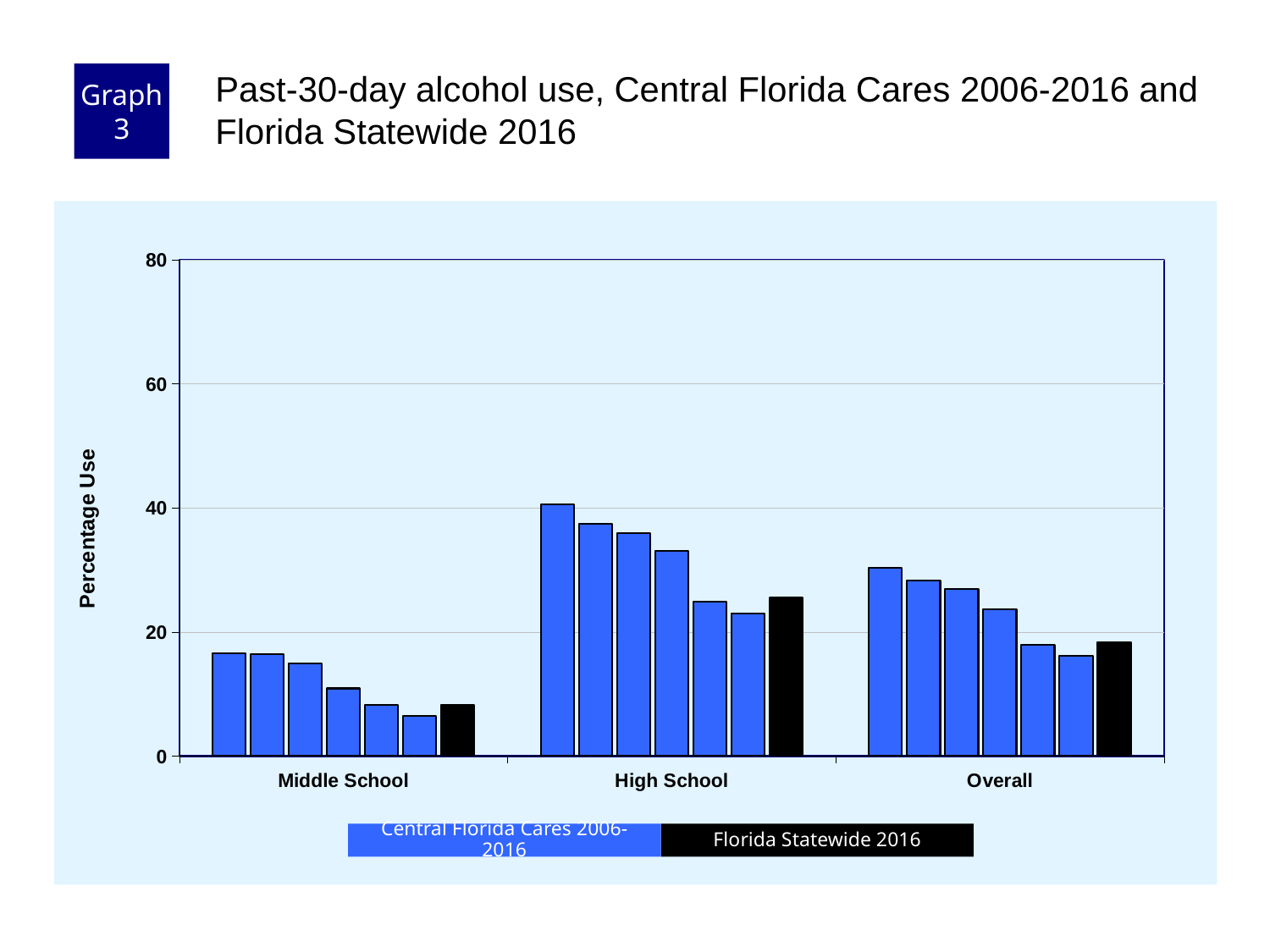
What kind of chart is shown on the slide? bar chart Is the Florida Statewide 2016 value for Middle School greater or less than 20? less How many series does the legend list? 2 Is the first Central Florida Cares bar for Overall greater or less than 20? greater How many categories are shown on the x axis? 3 Is the first Central Florida Cares bar for Overall greater or less than 40? less Within each category, do the Central Florida Cares 2006-2016 bars rise or fall from left to right? fall What is the label on the y axis? Percentage Use Which is larger, the Florida Statewide 2016 value for High School or for Middle School? High School Which category has the lowest bars? Middle School Which category has the highest bars? High School